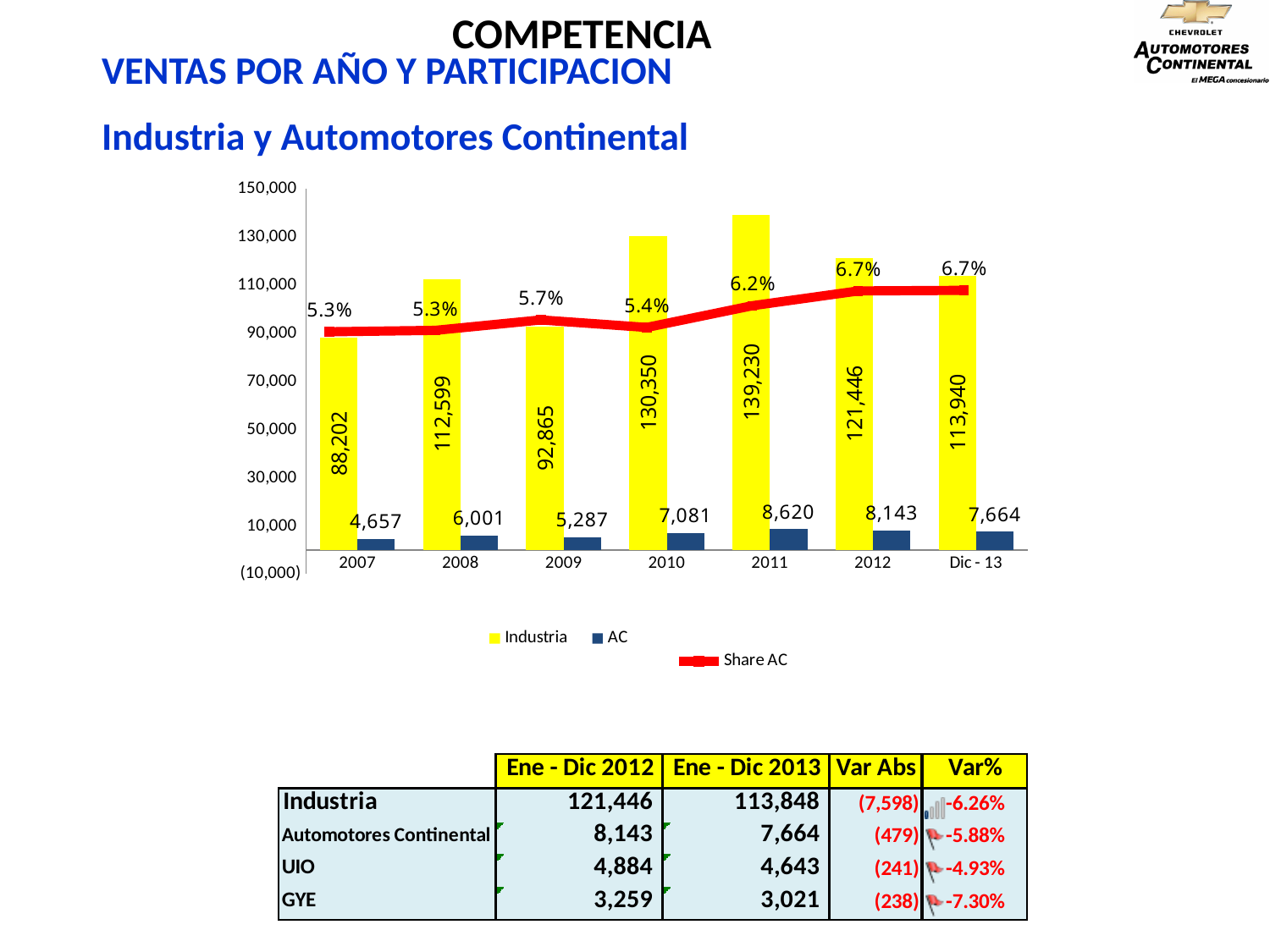
Which is larger, the AC value for 2012 or the AC value for Dic - 13? 2012 What is the Share AC value for 2010? 5.4% Is the Industria value for 2009 greater or less than 110,000? less What is the AC value for 2008? 6,001 Which year has the lowest AC value? 2007 What is the difference between the Industria values for 2011 and 2012? 17,784 How many series does the legend list? 3 Does the Share AC line rise or fall from 2010 to 2012? rise How many categories are shown on the x axis? 7 What is the Industria value for 2011? 139,230 Which year has the highest Industria value? 2011 What kind of chart is this? Combined bar and line chart